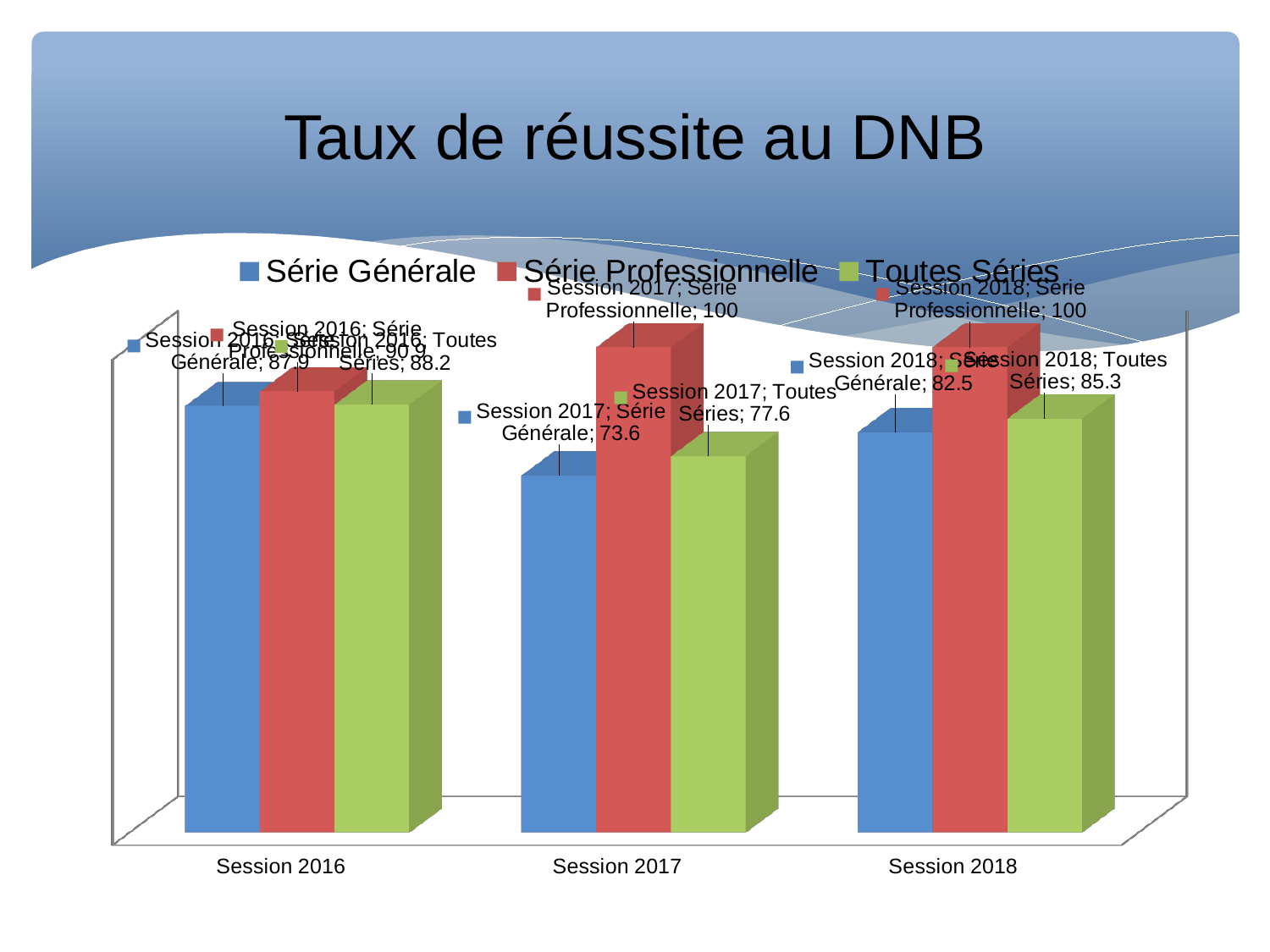
What is the value for Série Professionnelle in Session 2018? 100 How many sessions are shown on the x axis? 3 What type of chart is shown on the slide? bar chart Which session has the lowest value for Série Générale? Session 2017 What is the value for Toutes Séries in Session 2018? 85.3 What is the title of the chart? Taux de réussite au DNB Which series has the highest value in Session 2017? Série Professionnelle Which is larger: Série Générale in Session 2016 or Série Générale in Session 2018? Session 2016 What is the difference between Toutes Séries and Série Générale in Session 2017? 4 What is the value for Série Générale in Session 2017? 73.6 How many series does the legend list? 3 What is the value for Série Générale in Session 2016? 87.9